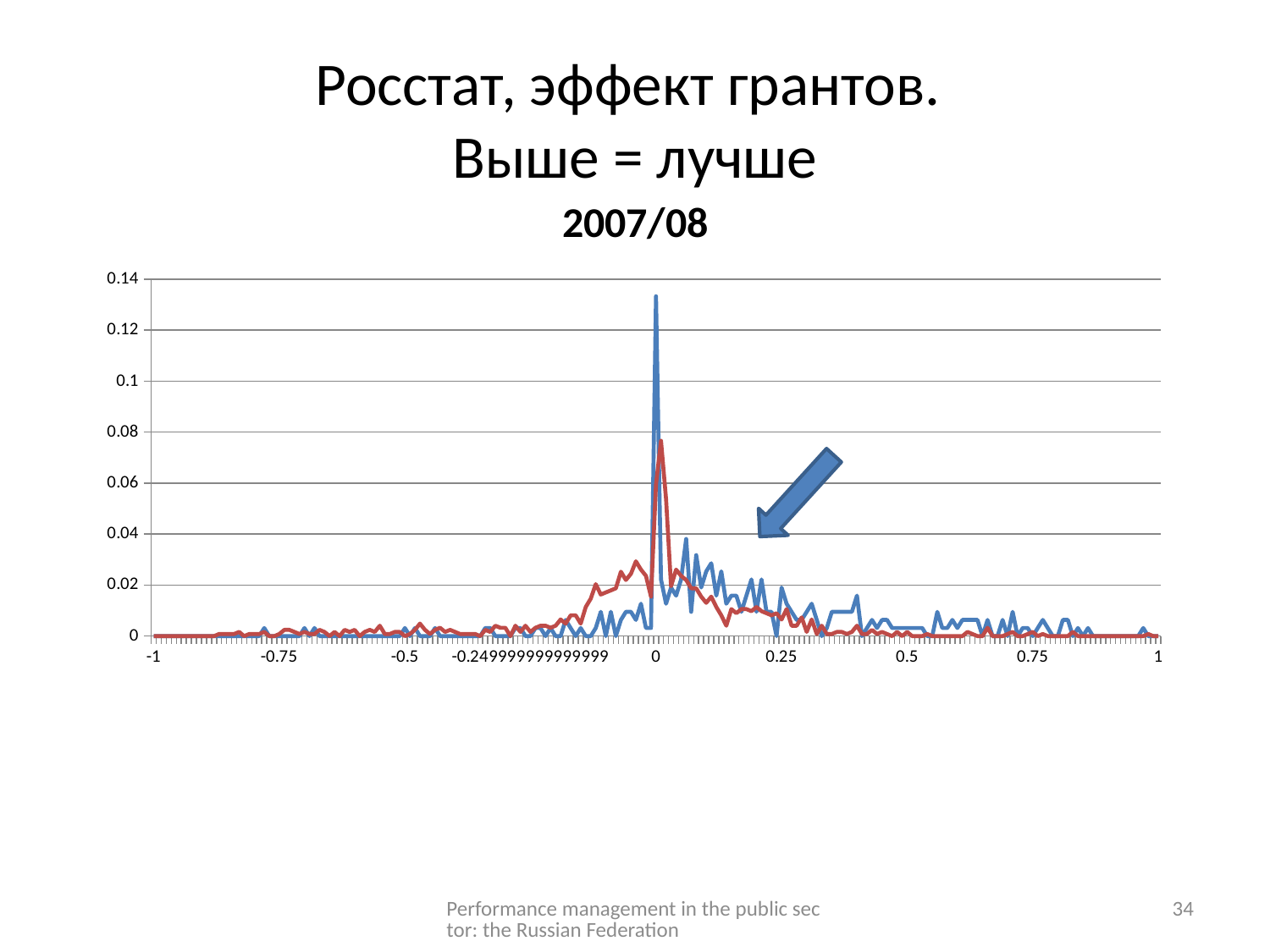
Just to the left of x = 0 (around x = -0.1), which line is higher, the blue one or the red one? red How many lines are plotted on the chart? 2 What is the title of the chart? 2007/08 Which line reaches the highest peak on the chart, the blue one or the red one? blue What colour is the large arrow drawn over the chart? blue Is the value of the blue line at x = 0.5 greater or less than 0.02? less Is the peak value of the blue line at x = 0 greater or less than 0.12? greater Between x = 0.25 and x = 0.5, which line is generally higher, the blue one or the red one? blue Is the peak value of the red line near x = 0 greater or less than 0.06? greater What kind of chart is shown on the slide? line chart At which x-axis value does the blue line reach its highest peak? 0